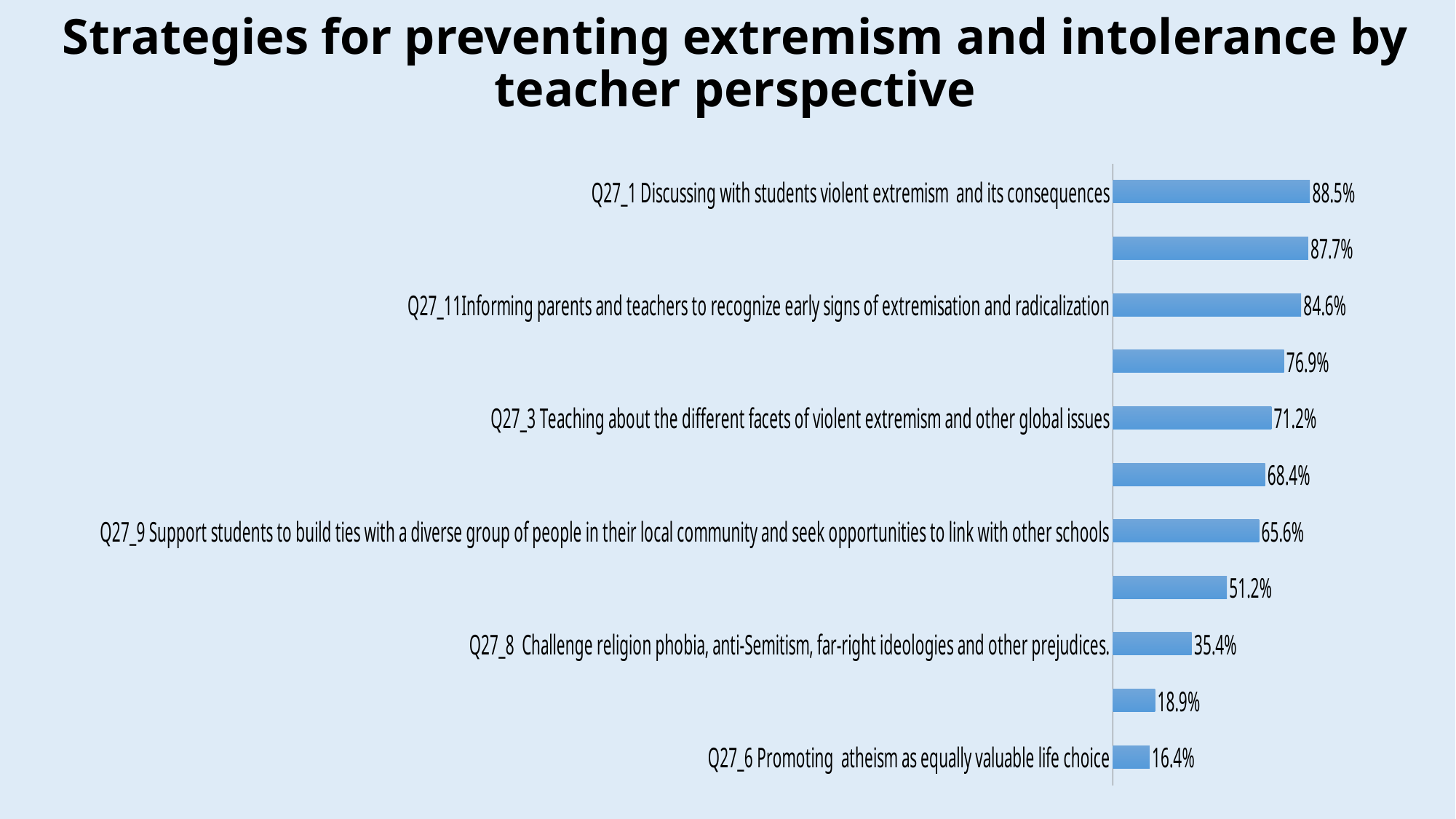
Which strategy has the highest value? Q27_1 Discussing with students violent extremism and its consequences What is the value for Q27_8 Challenge religion phobia, anti-Semitism, far-right ideologies and other prejudices? 35.4% What is the value for Q27_3 Teaching about the different facets of violent extremism and other global issues? 71.2% How many bars are plotted in the chart? 11 Which strategy has the lowest value? Q27_6 Promoting atheism as equally valuable life choice What is the difference between the values for Q27_3 Teaching about the different facets of violent extremism and Q27_8 Challenge religion phobia, anti-Semitism, far-right ideologies and other prejudices? 35.8 percentage points What is the value for Q27_11 Informing parents and teachers to recognize early signs of extremisation and radicalization? 84.6% What is the title of the chart? Strategies for preventing extremism and intolerance by teacher perspective What is the value for Q27_6 Promoting atheism as equally valuable life choice? 16.4% Which is larger, the value for Q27_9 Support students to build ties with a diverse group of people or the value for Q27_8 Challenge religion phobia, anti-Semitism, far-right ideologies and other prejudices? Q27_9 Support students to build ties with a diverse group of people What is the value for Q27_1 Discussing with students violent extremism and its consequences? 88.5% What kind of chart is shown on the slide? Bar chart